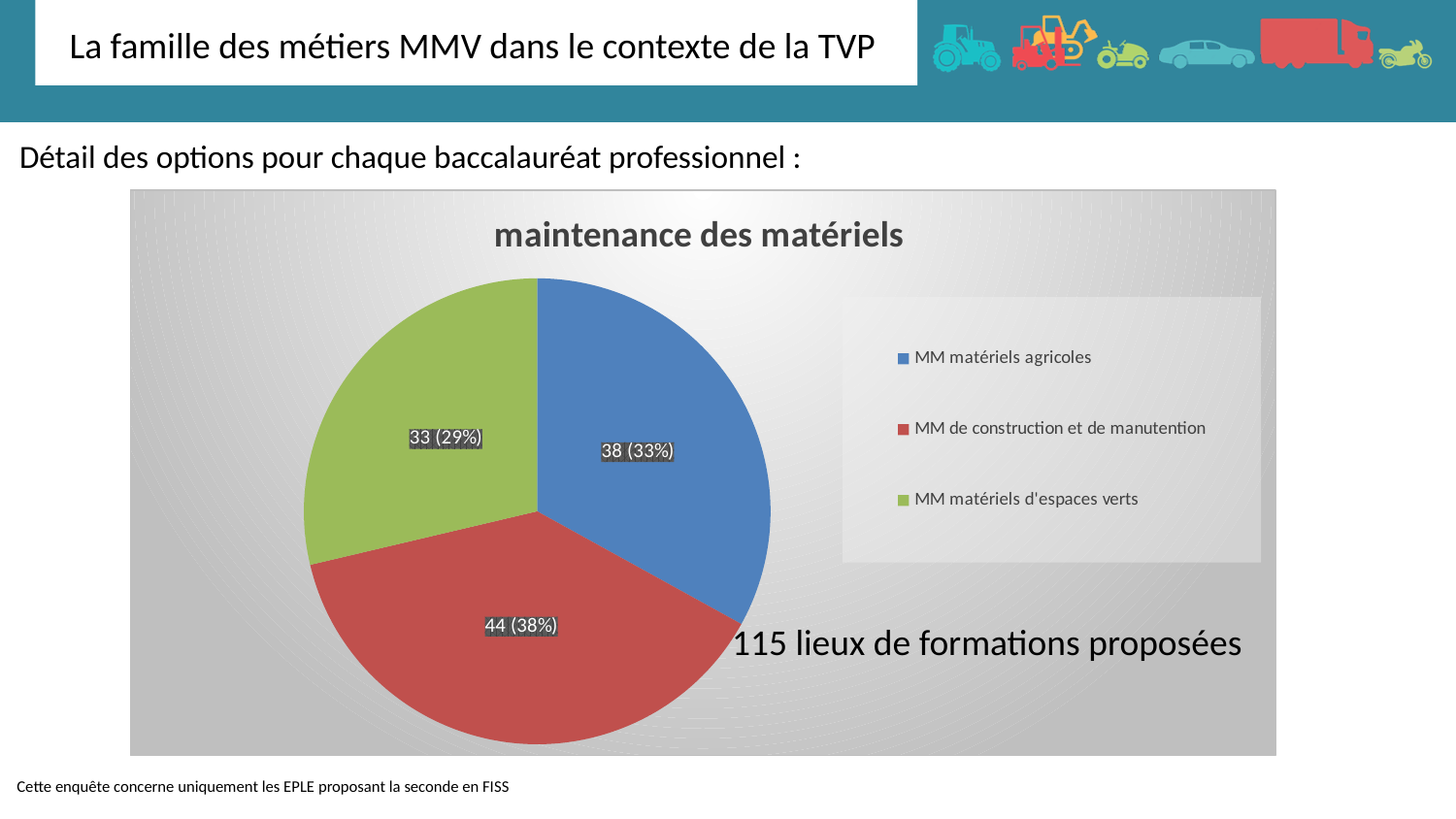
How many entries does the legend list? 3 Which category has the largest slice? MM de construction et de manutention What share of the pie does MM de construction et de manutention represent? 38% How many slices does the pie chart have? 3 What is the value for MM de construction et de manutention? 44 What is the value for MM matériels d'espaces verts? 33 Which category has the smallest slice? MM matériels d'espaces verts What is the value for MM matériels agricoles? 38 What kind of chart is shown on the slide? pie chart What share of the pie does MM matériels d'espaces verts represent? 29% What is the difference between the values for MM de construction et de manutention and MM matériels agricoles? 6 What is the title of the chart? maintenance des matériels